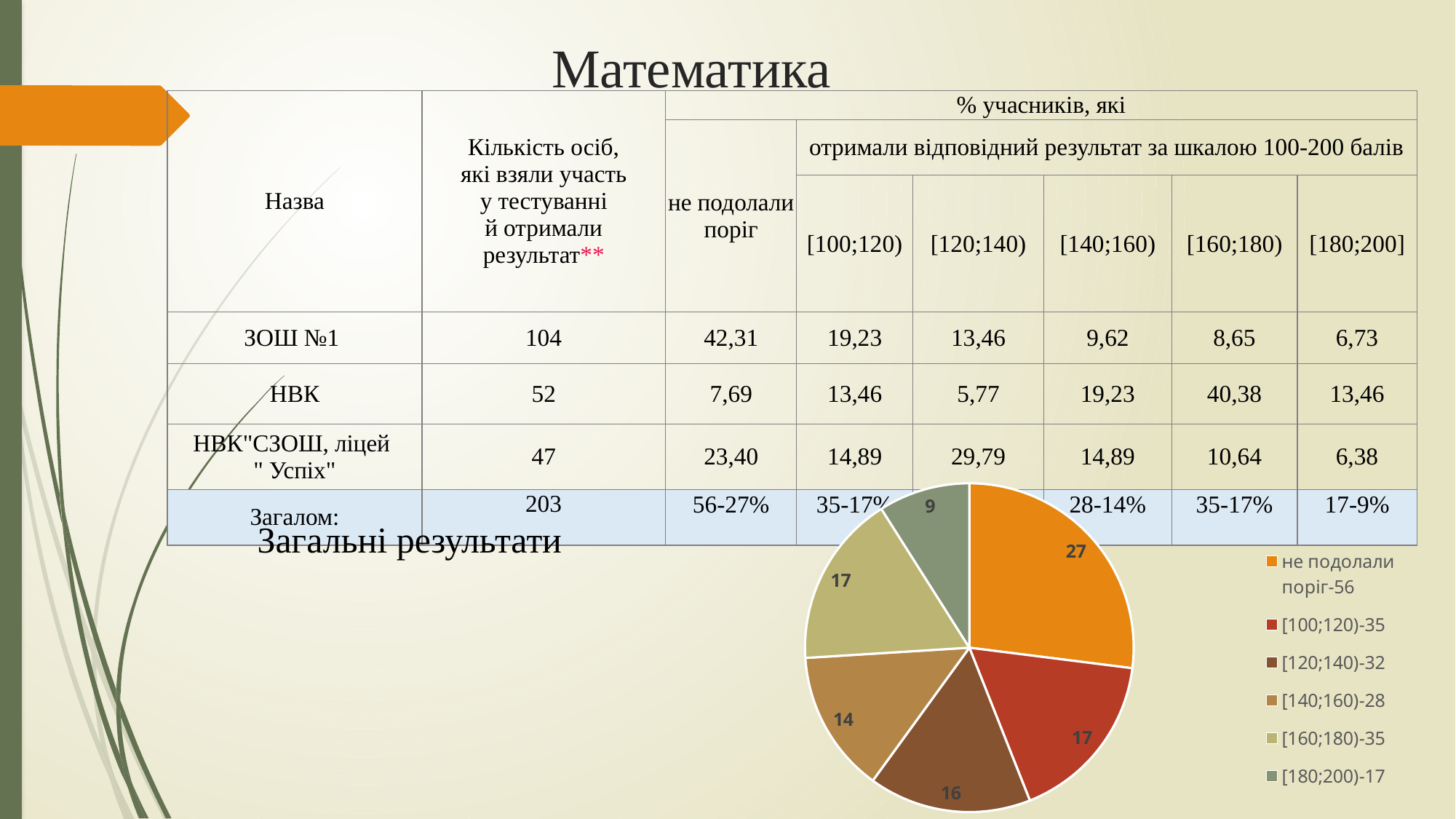
In the pie chart, what value is labelled on the slice for "не подолали поріг-56"? 27 In the pie chart, what value is labelled on the slice for "[180;200)-17"? 9 Which slice of the pie chart is the smallest? [180;200)-17 In the pie chart, what is the difference between the labelled values of the "не подолали поріг-56" slice and the "[180;200)-17" slice? 18 What kind of chart is shown on the slide? pie chart Which slice of the pie chart is the largest? не подолали поріг-56 What colour is the "не подолали поріг-56" slice in the pie chart? orange How many slices does the pie chart have? 6 How many entries does the pie chart's legend list? 6 In the pie chart, which slice has the larger labelled value: "[120;140)-32" or "[140;160)-28"? [120;140)-32 In the pie chart, what value is labelled on the slice for "[140;160)-28"? 14 In the pie chart, what value is labelled on the slice for "[120;140)-32"? 16